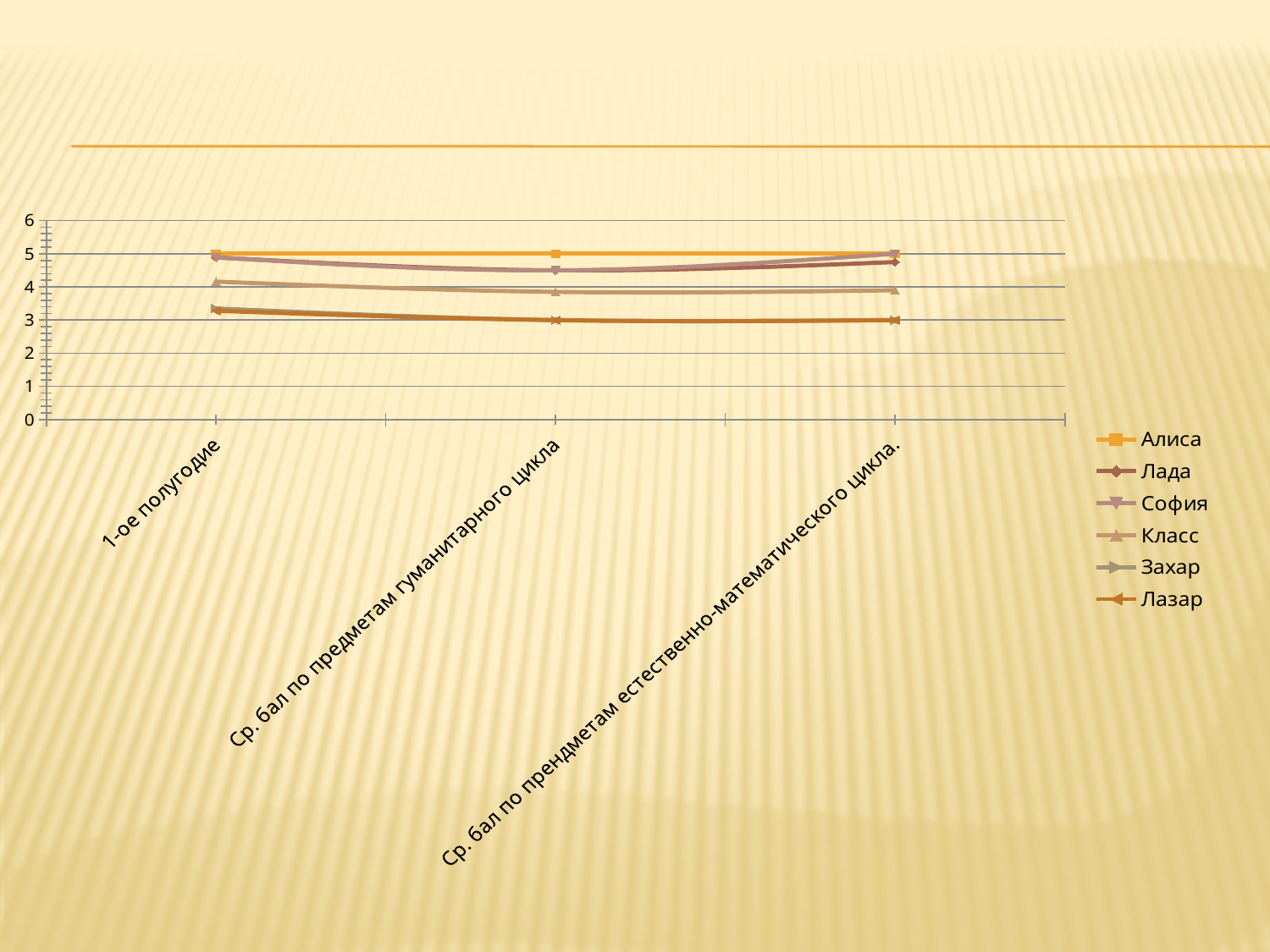
Is the value for Алиса at "1-ое полугодие" greater or less than 4? greater How many series does the legend list? 6 Is the value for Класс at "Ср. бал по предметам гуманитарного цикла" greater or less than 3? greater Which is larger at "Ср. бал по прендметам естественно-математического цикла.": the value for Алиса or the value for Лазар? Алиса Is the value for Лада at "Ср. бал по предметам гуманитарного цикла" greater or less than 4? greater What kind of chart is shown on the slide? line chart Which is larger at "1-ое полугодие": the value for Класс or the value for Захар? Класс Does the value for Лазар rise or fall from "1-ое полугодие" to "Ср. бал по предметам гуманитарного цикла"? fall Which series is listed first in the legend? Алиса Which series has the highest value at "Ср. бал по предметам гуманитарного цикла"? Алиса How many categories are shown on the x axis? 3